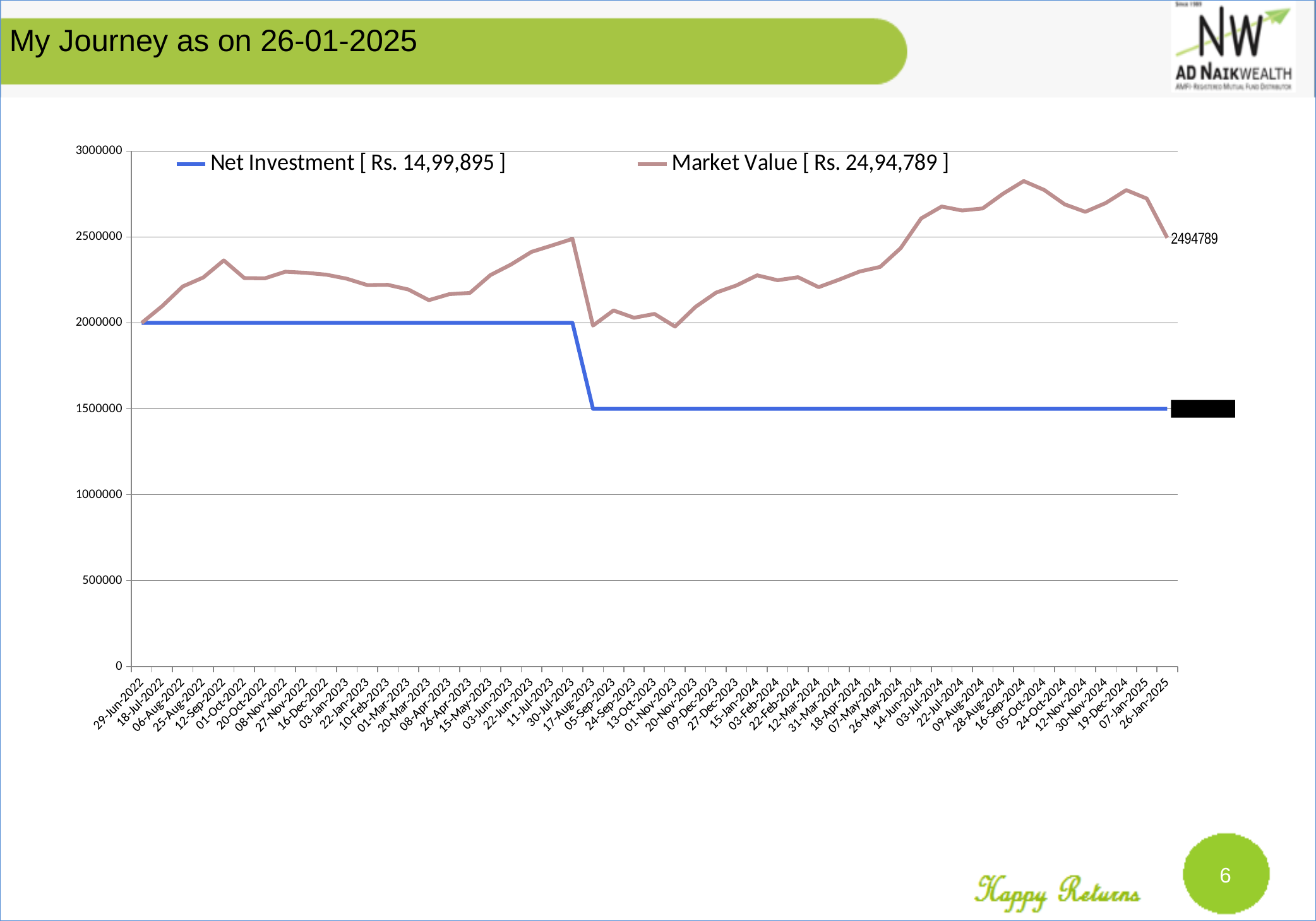
Does the Market Value line rise or fall between 01-Nov-2023 and 16-Sep-2024? rise What is the Market Value on 26-Jan-2025 according to the data label? 2494789 What kind of chart is shown on the slide? line chart What colour is the Net Investment line? blue Is the Net Investment value on 26-Jan-2025 greater or less than 2000000? less What is the difference between the Market Value and the Net Investment amounts shown in the legend? Rs. 9,94,894 How many series does the chart legend list? 2 Is the Market Value on 16-Sep-2024 greater or less than 2500000? greater What Market Value amount is shown in the legend entry? Rs. 24,94,789 What Net Investment amount is shown in the legend entry? Rs. 14,99,895 On which date does the Market Value line reach its highest point? 16-Sep-2024 On 26-Jan-2025, which is larger: Market Value or Net Investment? Market Value